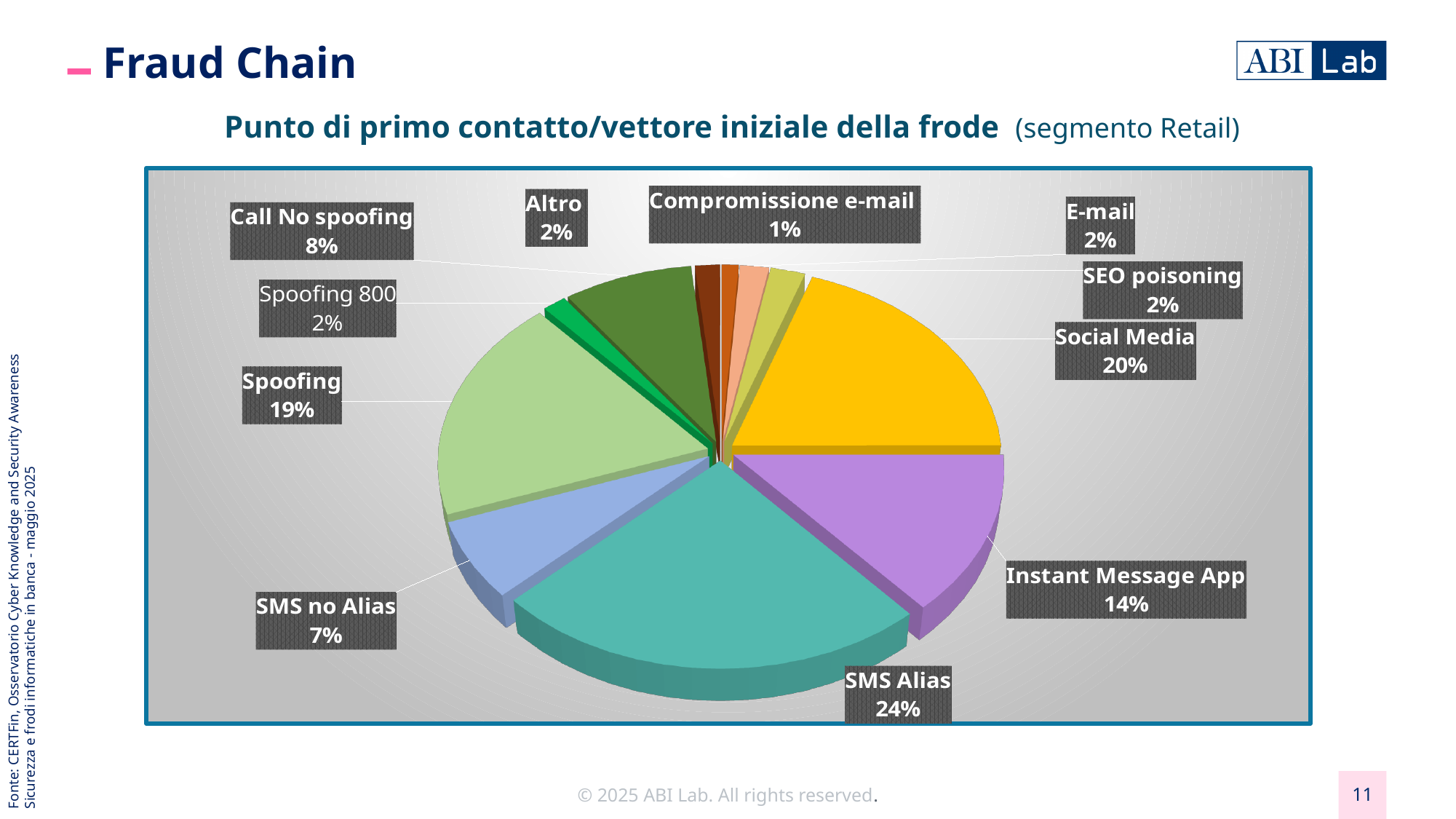
What share of the pie does SMS Alias represent? 24% What is the difference between the shares of SMS Alias and Instant Message App? 10% What kind of chart is shown on the slide? Pie chart What is the value for Spoofing? 19% What is the value for Instant Message App? 14% Which category has the largest share of the pie? SMS Alias What is the value for Social Media? 20% What is the title of the chart? Punto di primo contatto/vettore iniziale della frode (segmento Retail) Which category has the smallest share of the pie? Compromissione e-mail What is the value for Compromissione e-mail? 1% Which is larger, the share for Call No spoofing or the share for SMS no Alias? Call No spoofing How many categories are shown in the pie chart? 11